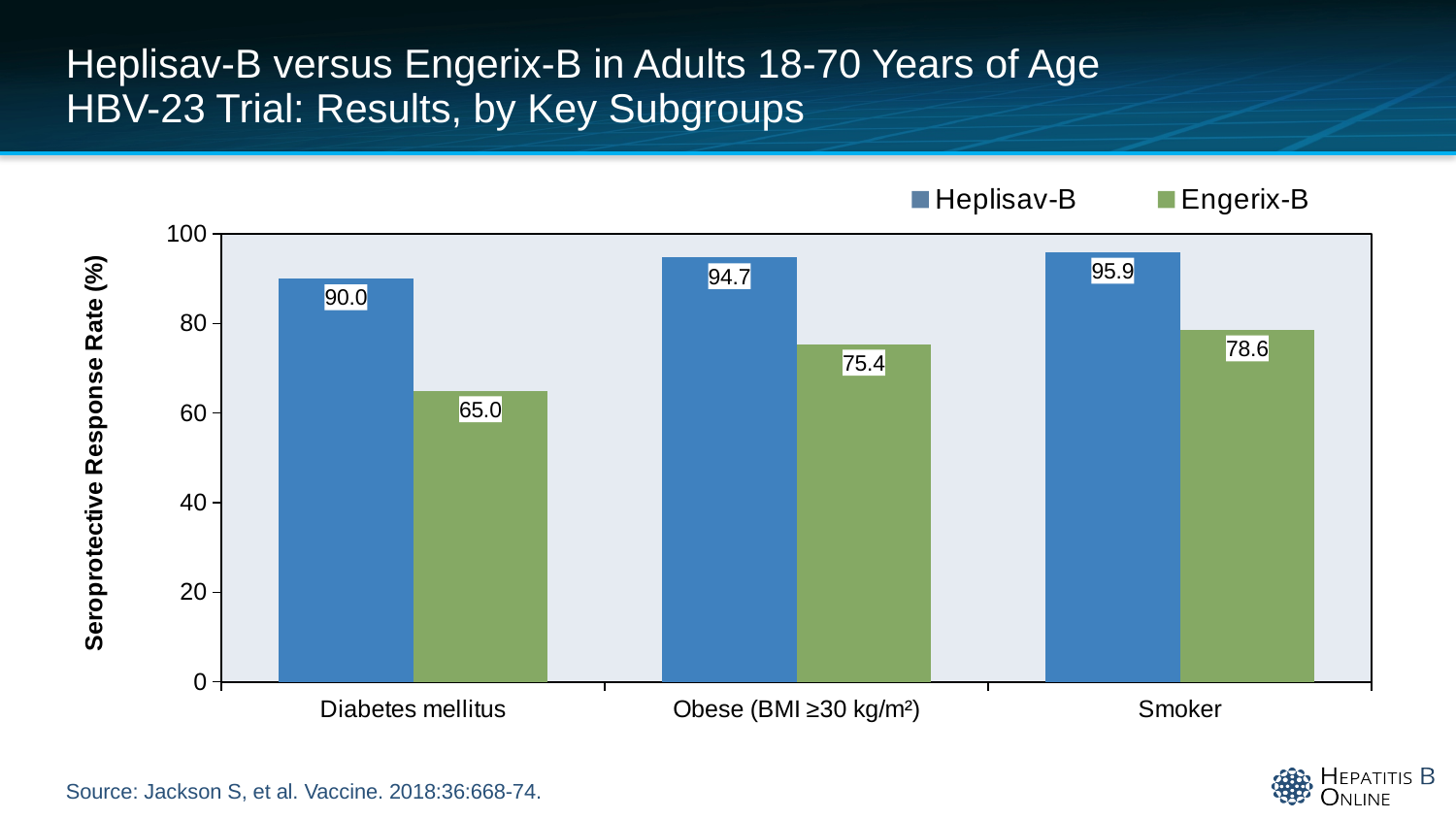
How many series does the legend list? 2 Which subgroup has the highest seroprotective response rate for Heplisav-B? Smoker What is the seroprotective response rate for Engerix-B in the Obese (BMI ≥30 kg/m²) subgroup? 75.4 Which subgroup has the lowest seroprotective response rate for Engerix-B? Diabetes mellitus What is the difference between the Heplisav-B and Engerix-B seroprotective response rates in the Diabetes mellitus subgroup? 25.0 What is the seroprotective response rate for Heplisav-B in the Diabetes mellitus subgroup? 90.0 What is the difference between the Heplisav-B and Engerix-B seroprotective response rates in the Smoker subgroup? 17.3 How many subgroups are shown on the x axis? 3 In the Obese (BMI ≥30 kg/m²) subgroup, which vaccine has the higher seroprotective response rate? Heplisav-B Is the Engerix-B value for the Diabetes mellitus subgroup greater or less than 80? less What kind of chart is shown on the slide? Bar chart What is the seroprotective response rate for Engerix-B in the Smoker subgroup? 78.6